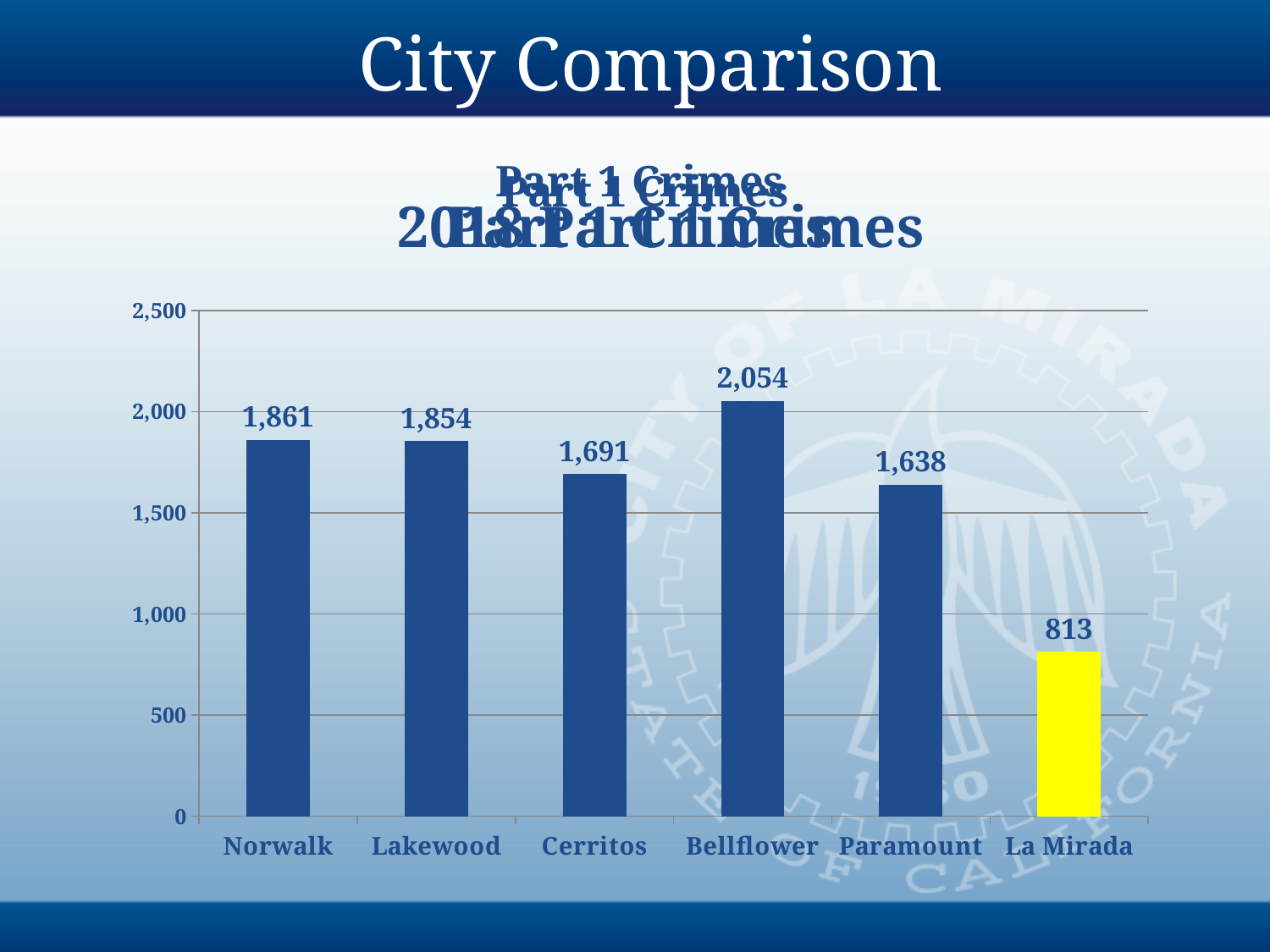
Which is larger, the value for Norwalk or the value for Paramount? Norwalk What is the value for Bellflower? 2,054 Which city has the highest value? Bellflower What is the difference between the values for Cerritos and Paramount? 53 What is the difference between the values for Bellflower and La Mirada? 1,241 What is the value for Cerritos? 1,691 Which city has the lowest value? La Mirada Is the value for La Mirada greater or less than 1,000? less How many cities are shown in the chart? 6 What is the value for Paramount? 1,638 What kind of chart is shown on the slide? bar chart What is the value for La Mirada? 813